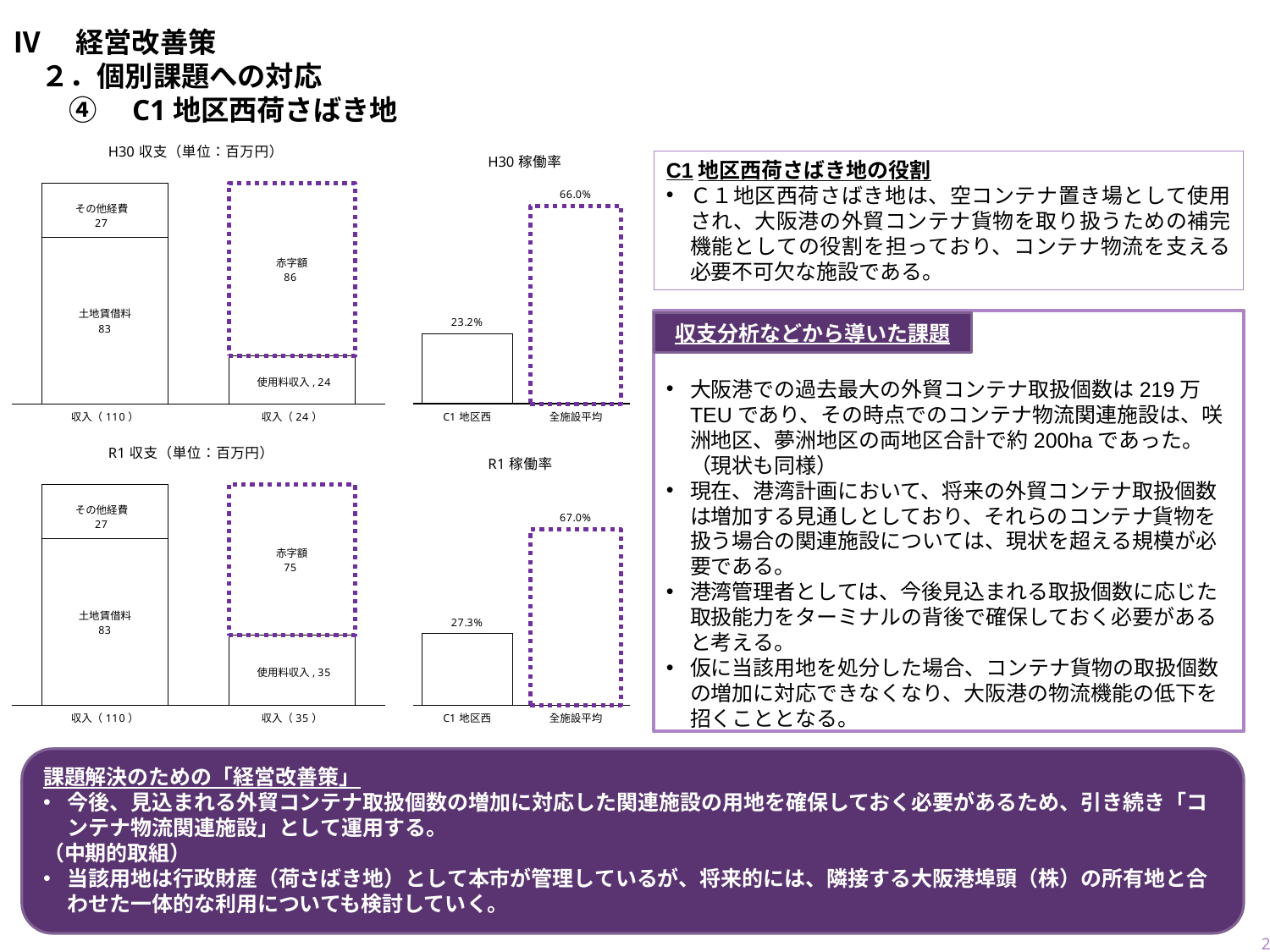
In the H30 稼働率 chart, what is the value for 全施設平均? 66.0% In the H30 稼働率 chart, what is the difference between 全施設平均 and C1 地区西? 42.8% In the H30 収支 chart, what is the value of 土地賃借料? 83 In the R1 収支 chart, what is the value of 赤字額? 75 In the H30 収支 chart, what is the value of 赤字額? 86 In the R1 収支 chart, what is the total of the bar made up of 使用料収入 and 赤字額? 110 In the R1 稼働率 chart, which category is higher, C1 地区西 or 全施設平均? 全施設平均 In the R1 稼働率 chart, what is the value for C1 地区西? 27.3% In the R1 収支 chart, what is the value of 使用料収入? 35 In the H30 収支 chart, what is the value of 使用料収入? 24 In the H30 稼働率 chart, what is the value for C1 地区西? 23.2% What kind of chart is the R1 稼働率 chart? Bar chart